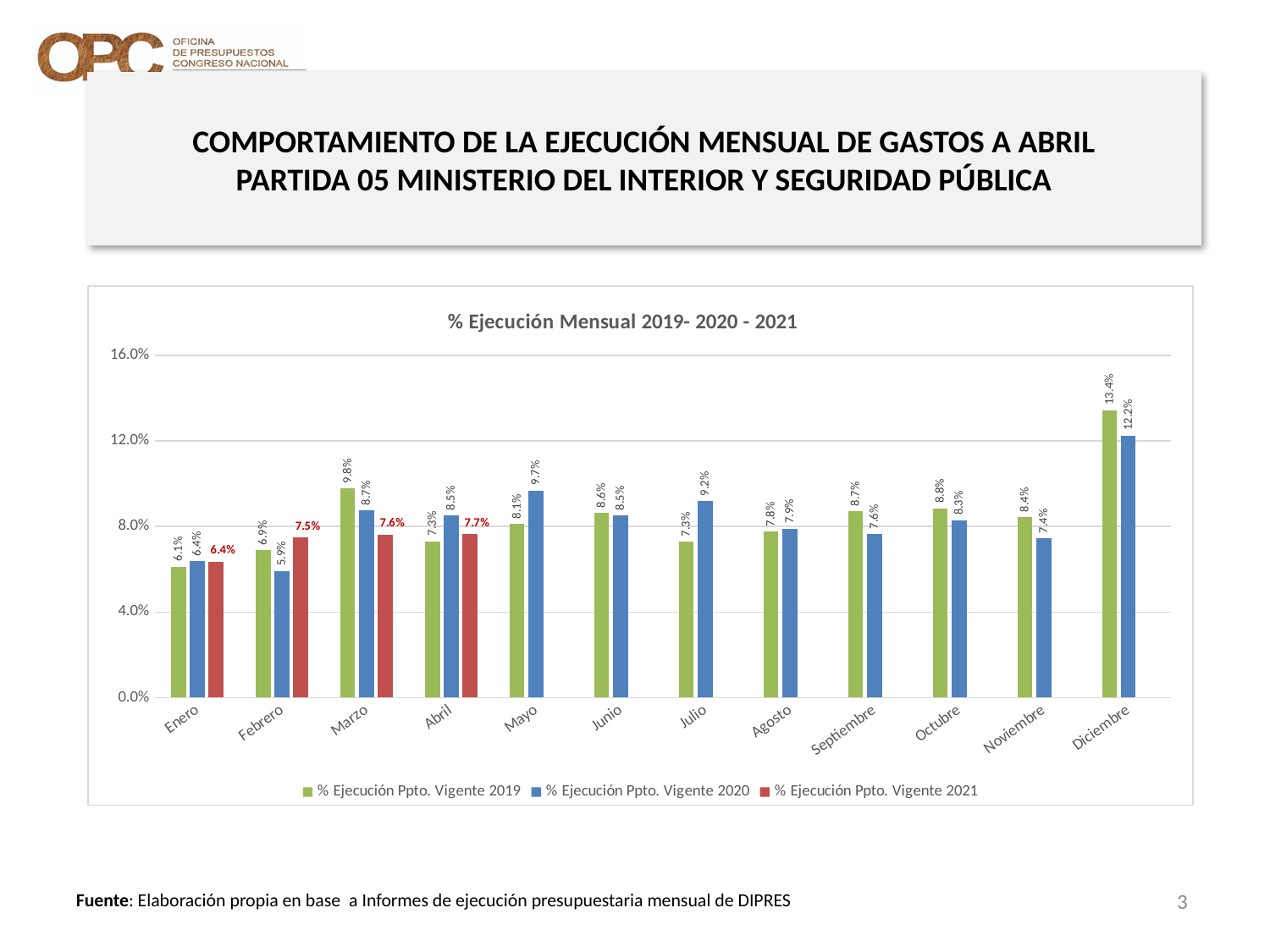
Which month has the lowest value for % Ejecución Ppto. Vigente 2020? Febrero What is the value for % Ejecución Ppto. Vigente 2019 in Marzo? 9.8% What is the value for % Ejecución Ppto. Vigente 2020 in Diciembre? 12.2% What kind of chart is shown on the slide? Bar chart Which month has the highest value for % Ejecución Ppto. Vigente 2019? Diciembre Which is larger in Mayo: the 2019 value or the 2020 value? 2020 value (9.7%) Is the value for % Ejecución Ppto. Vigente 2019 in Diciembre greater or less than 12.0%? greater What is the value for % Ejecución Ppto. Vigente 2021 in Abril? 7.7% How many months are shown on the x axis? 12 What is the difference between the 2019 and 2020 values in Diciembre? 1.2% How many series does the legend list? 3 What is the title of the chart? % Ejecución Mensual 2019- 2020 - 2021